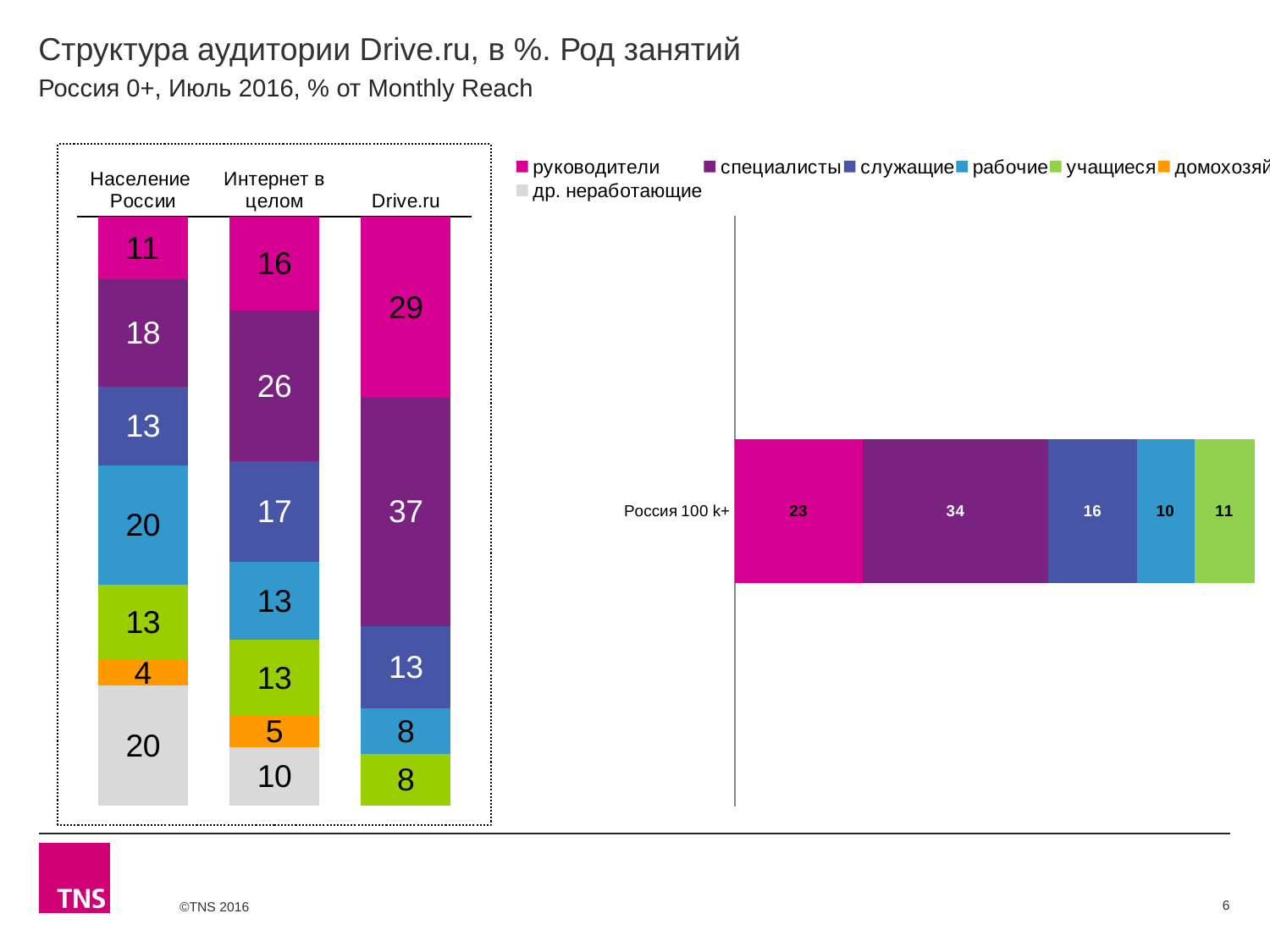
In the left stacked bar chart, which segment is the smallest in the Население России bar? домохозяйки In the left stacked bar chart, what is the value for специалисты in the Drive.ru bar? 37 What type of chart is shown on the right side of the slide? Stacked bar chart In the left stacked bar chart, which bar has the highest value for руководители? Drive.ru In the left stacked bar chart, what is the value for руководители in the Население России bar? 11 In the right chart (Россия 100 k+), what is the value for специалисты? 34 How many bars does the left stacked bar chart show? 3 What is the total of the Интернет в целом bar in the left stacked bar chart? 100 In the left stacked bar chart, what is the difference between the специалисты values for Drive.ru and Интернет в целом? 11 In the right chart (Россия 100 k+), what is the value for учащиеся? 11 In the left stacked bar chart, what is the value for рабочие in the Интернет в целом bar? 13 In the left stacked bar chart, which is larger: рабочие for Население России or рабочие for Drive.ru? Население России